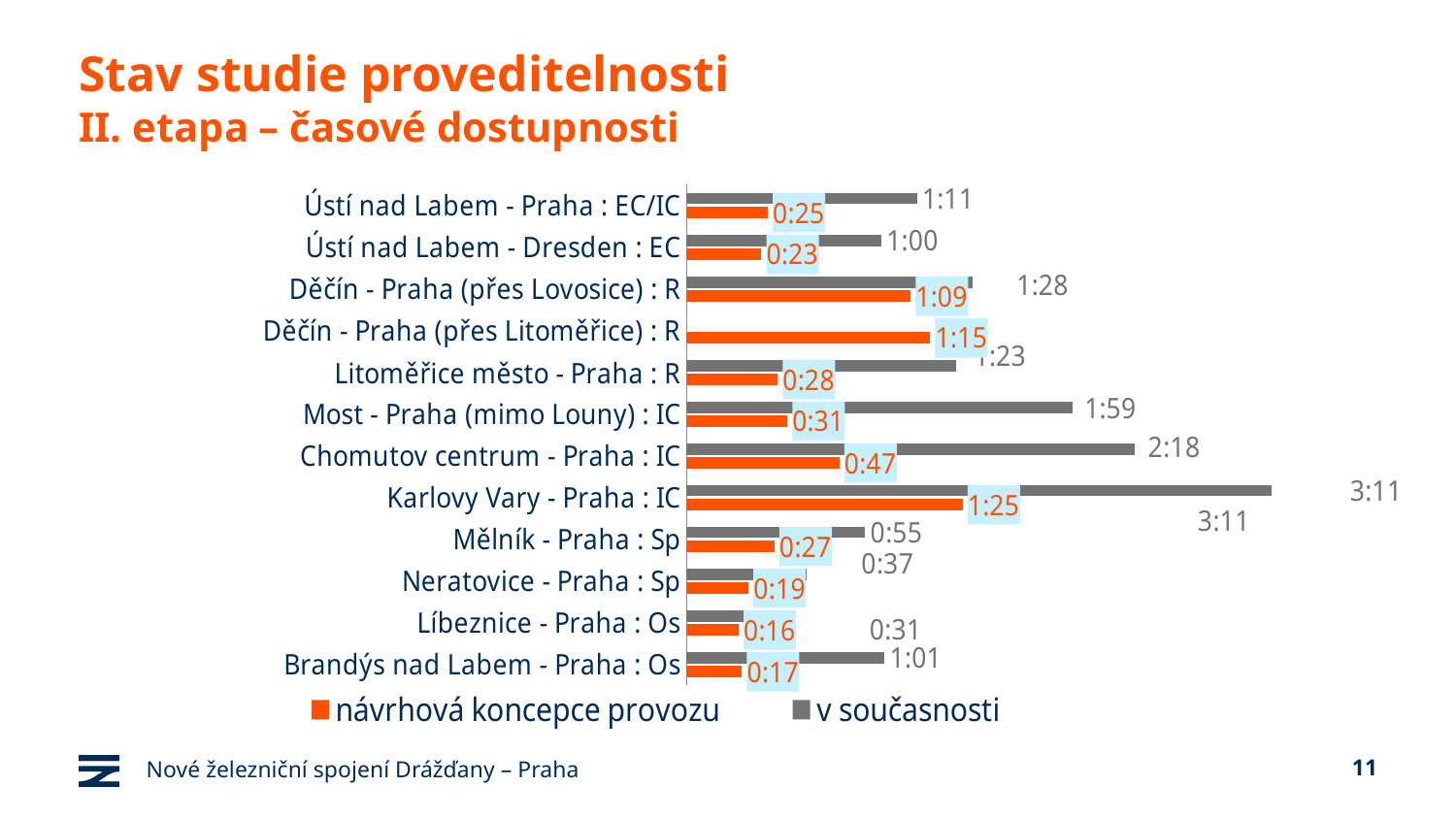
What is the value of 'návrhová koncepce provozu' for Ústí nad Labem - Praha : EC/IC? 0:25 What is the value of 'v současnosti' for Chomutov centrum - Praha : IC? 2:18 Which category has the highest 'v současnosti' value? Karlovy Vary - Praha : IC Which is larger: the 'v současnosti' value for Most - Praha (mimo Louny) : IC or for Chomutov centrum - Praha : IC? Chomutov centrum - Praha : IC What is the difference between the 'v současnosti' and 'návrhová koncepce provozu' values for Ústí nad Labem - Praha : EC/IC? 0:46 What kind of chart is shown on the slide? Bar chart What is the value of 'návrhová koncepce provozu' for Děčín - Praha (přes Litoměřice) : R? 1:15 Which category has the lowest 'návrhová koncepce provozu' value? Líbeznice - Praha : Os How many categories (routes) are shown in the chart? 12 Which colour represents the 'v současnosti' series? Grey What is the value of 'v současnosti' for Karlovy Vary - Praha : IC? 3:11 How many series does the legend list? 2